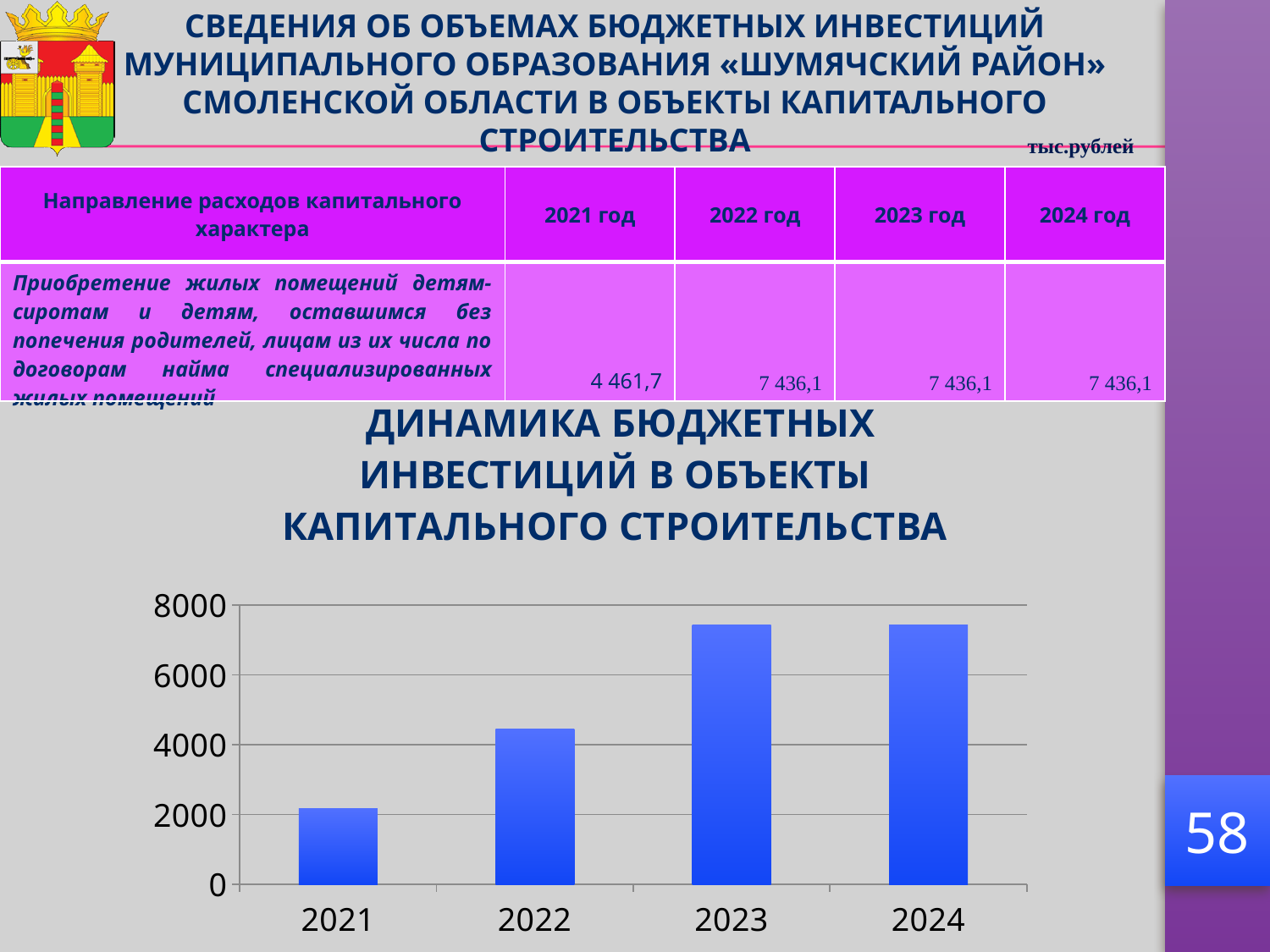
Is the value for 2023 in the chart greater or less than 6000? greater What kind of chart is shown on the slide? bar chart Do the bar values rise or fall from 2021 to 2023 in the chart? rise Is the value for 2021 in the chart greater or less than 4000? less What is the highest value shown on the vertical axis of the chart? 8000 Is the value for 2022 in the chart greater or less than 4000? greater How many years are shown on the x axis of the chart? 4 Which year has the lowest bar in the chart? 2021 Which bar is taller in the chart, 2022 or 2023? 2023 Which bar is taller in the chart, 2021 or 2022? 2022